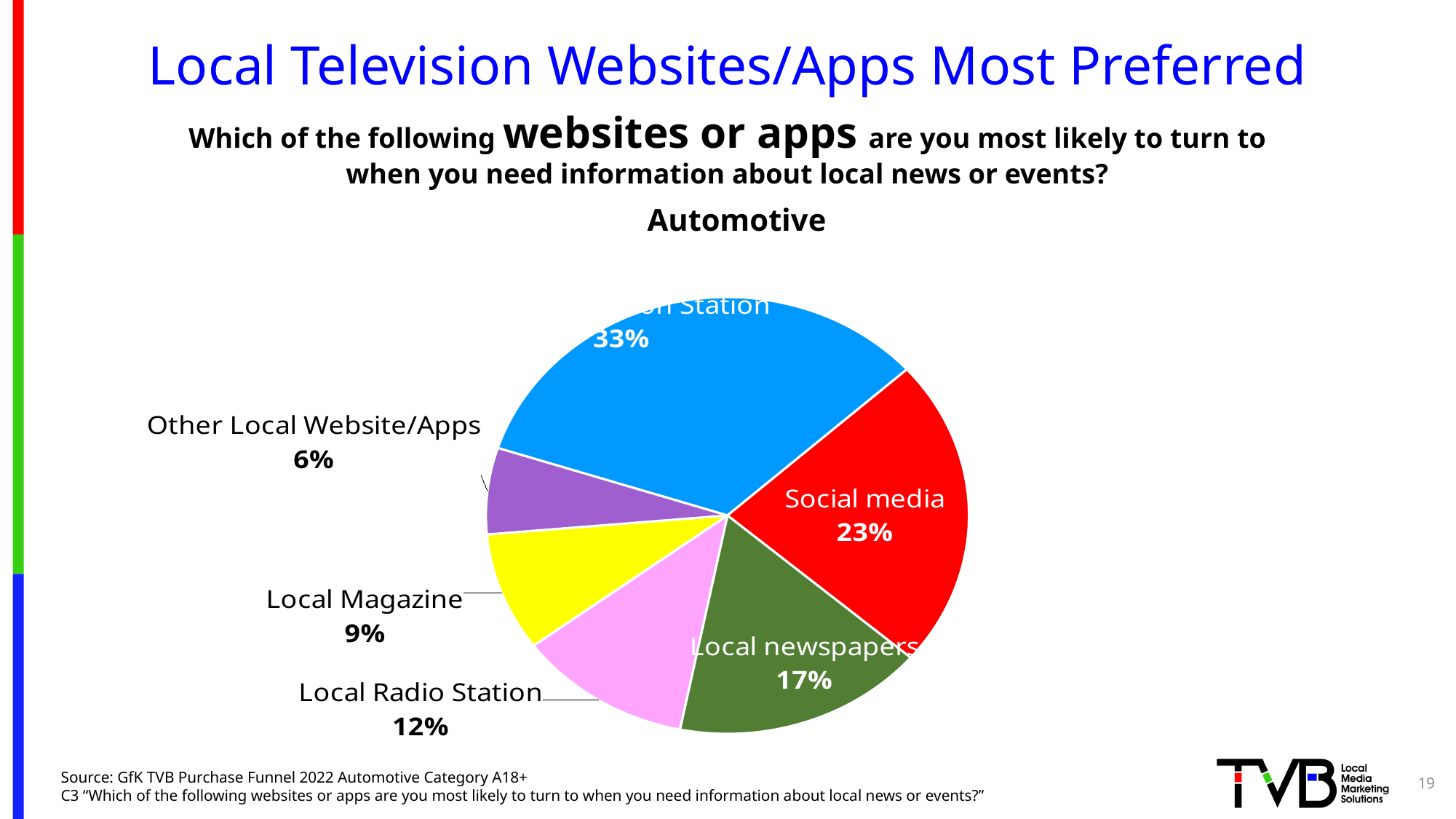
What is the difference in percentage points between Social media and Local newspapers? 6 What percentage is shown for Local Radio Station? 12% What percentage is shown for Other Local Website/Apps? 6% Which category has the smallest slice of the pie? Other Local Website/Apps Which is larger, Local Radio Station or Local Magazine? Local Radio Station What percentage is shown for Local Magazine? 9% How many slices does the pie chart have? 6 What share of the pie does Local newspapers have? 17% What share of the pie does Social media have? 23% What percentage is shown on the largest (blue) slice of the pie? 33% What is the title shown directly above the pie chart? Automotive What kind of chart is shown on the slide? pie chart